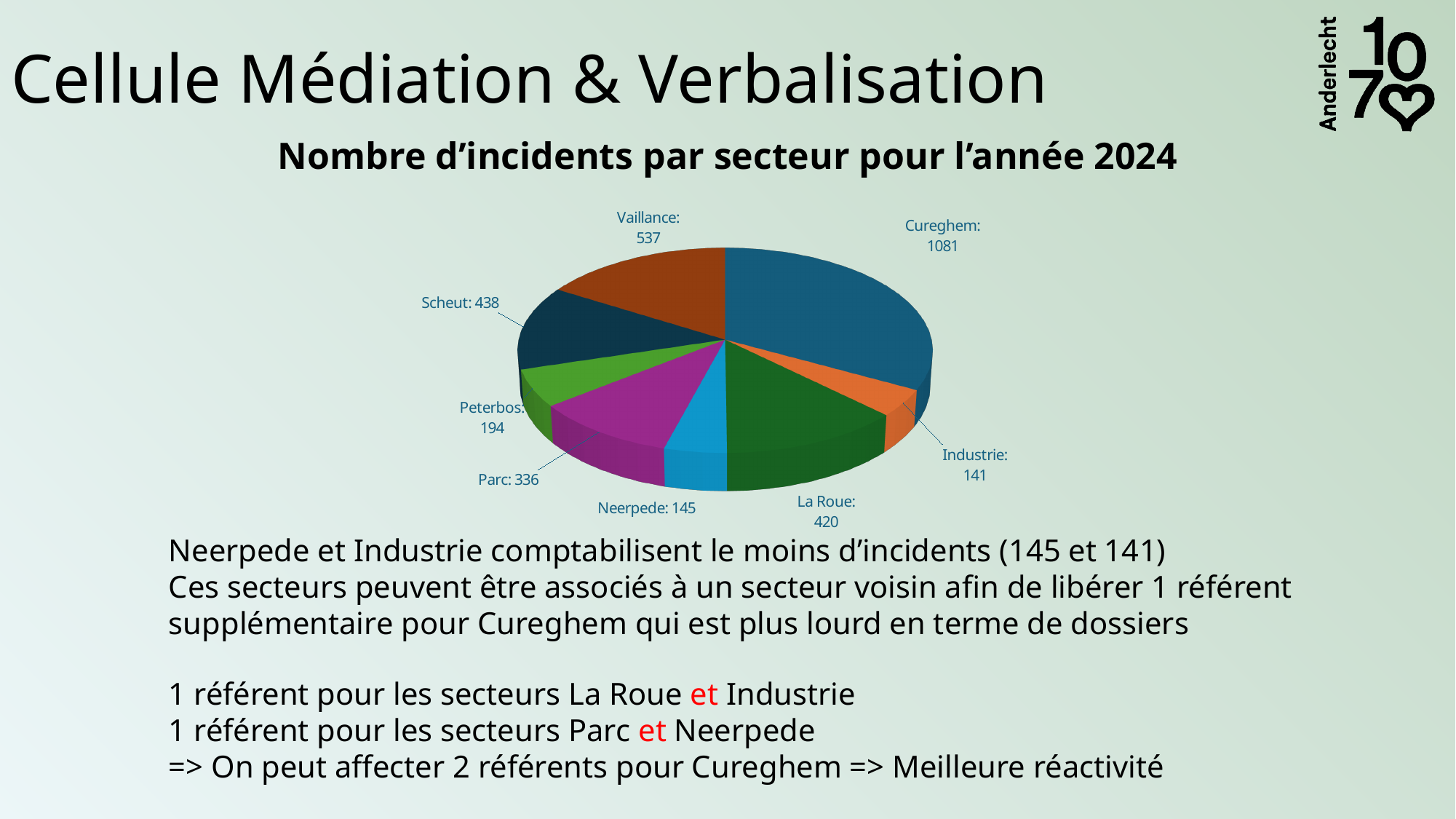
How many sectors (slices) does the pie chart show? 8 What is the title of the chart? Nombre d'incidents par secteur pour l'année 2024 What is the difference between the values for Vaillance and Scheut? 99 What is the total number of incidents across all sectors in the pie chart? 3292 Which has more incidents, La Roue or Parc? La Roue What kind of chart is shown on the slide? pie chart Which sector has the highest number of incidents? Cureghem Which sector has the lowest number of incidents? Industrie What is the difference between the values for Cureghem and La Roue? 661 How many incidents are shown for Peterbos? 194 What is the value for Scheut? 438 What is the value for Vaillance? 537